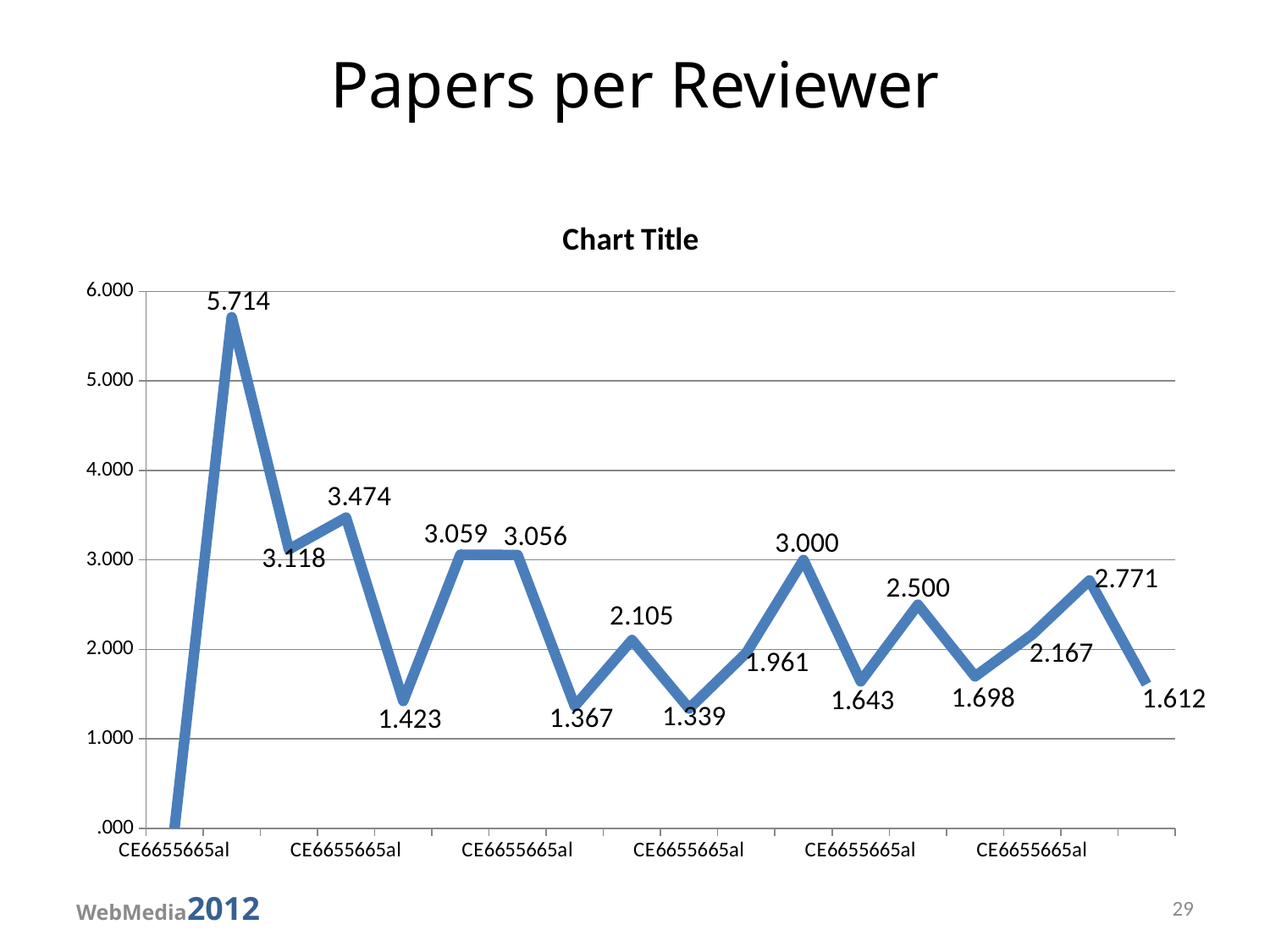
What is the title printed above the chart area? Chart Title What is the value of the point labeled immediately after the 5.714 peak? 3.118 Which is larger, the point labeled 2.500 or the point labeled 2.771? 2.771 What is the value of the last (rightmost) point on the line? 1.612 What kind of chart is shown on the slide? line chart What is the maximum value shown on the vertical axis? 6.000 What is the difference between the peak value 5.714 and the next labeled value 3.118? 2.596 After the peak at 5.714, do the values overall rise or fall toward the right end of the chart? fall What is the highest value labeled on the chart? 5.714 Is the value of the highest point greater or less than 5.000? greater Is the value of the rightmost point greater or less than 2.000? less What is the lowest value labeled on the chart? 1.339